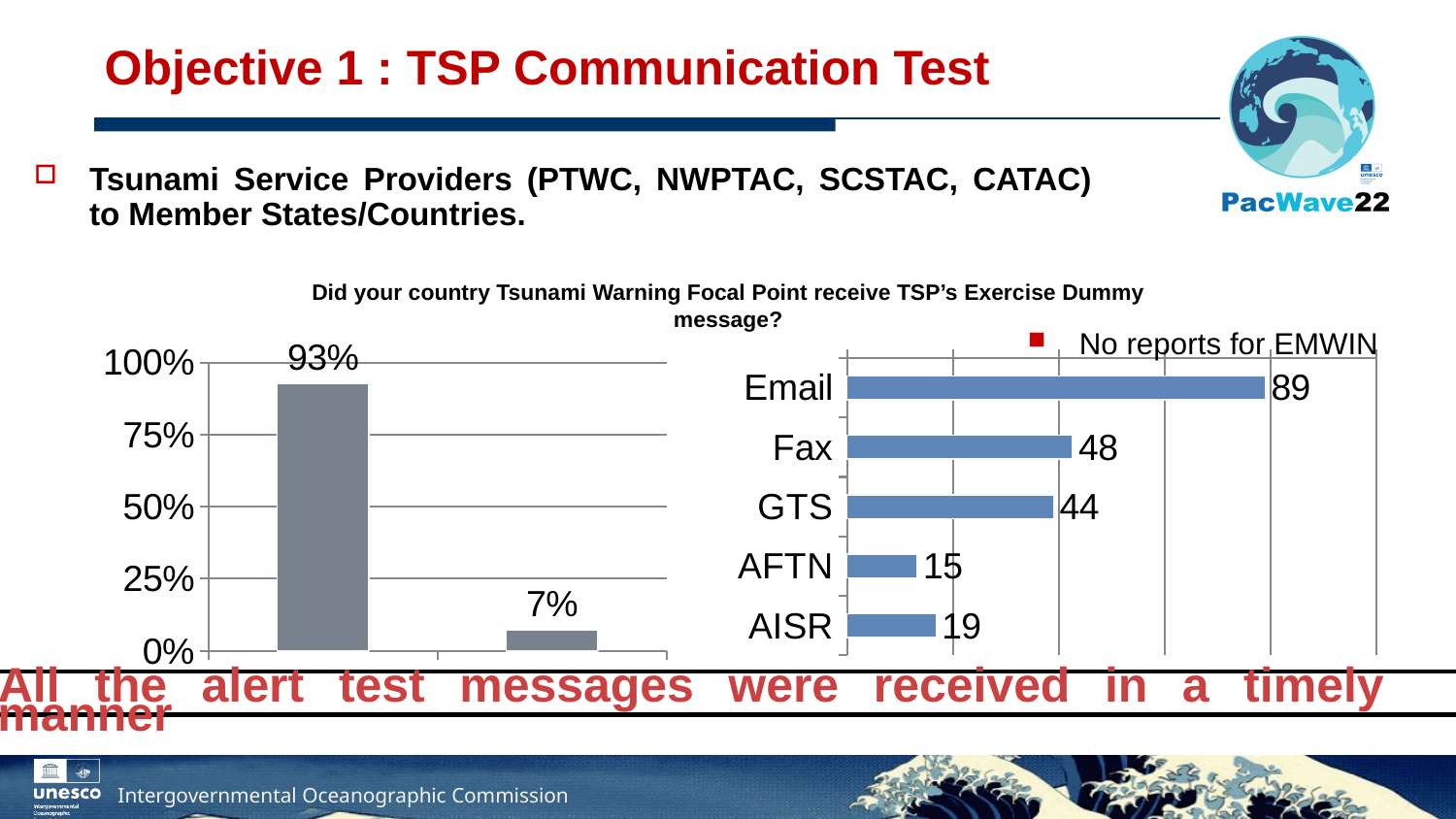
On the right chart, what is the value for Email? 89 On the left chart, what is the value of the shorter bar? 7% How many bars are plotted on the left chart? 2 On the left chart, what is the value of the taller bar? 93% On the right chart, what is the difference between the values for Fax and GTS? 4 On the right chart, what is the value for AFTN? 15 On the right chart, which category has the lowest value? AFTN On the right chart, which category has the highest value? Email What kind of chart is the left chart? Bar chart On the left chart, what is the difference between the two bars' values? 86% On the right chart, what is the value for GTS? 44 On the right chart, which has a larger value, AISR or AFTN? AISR